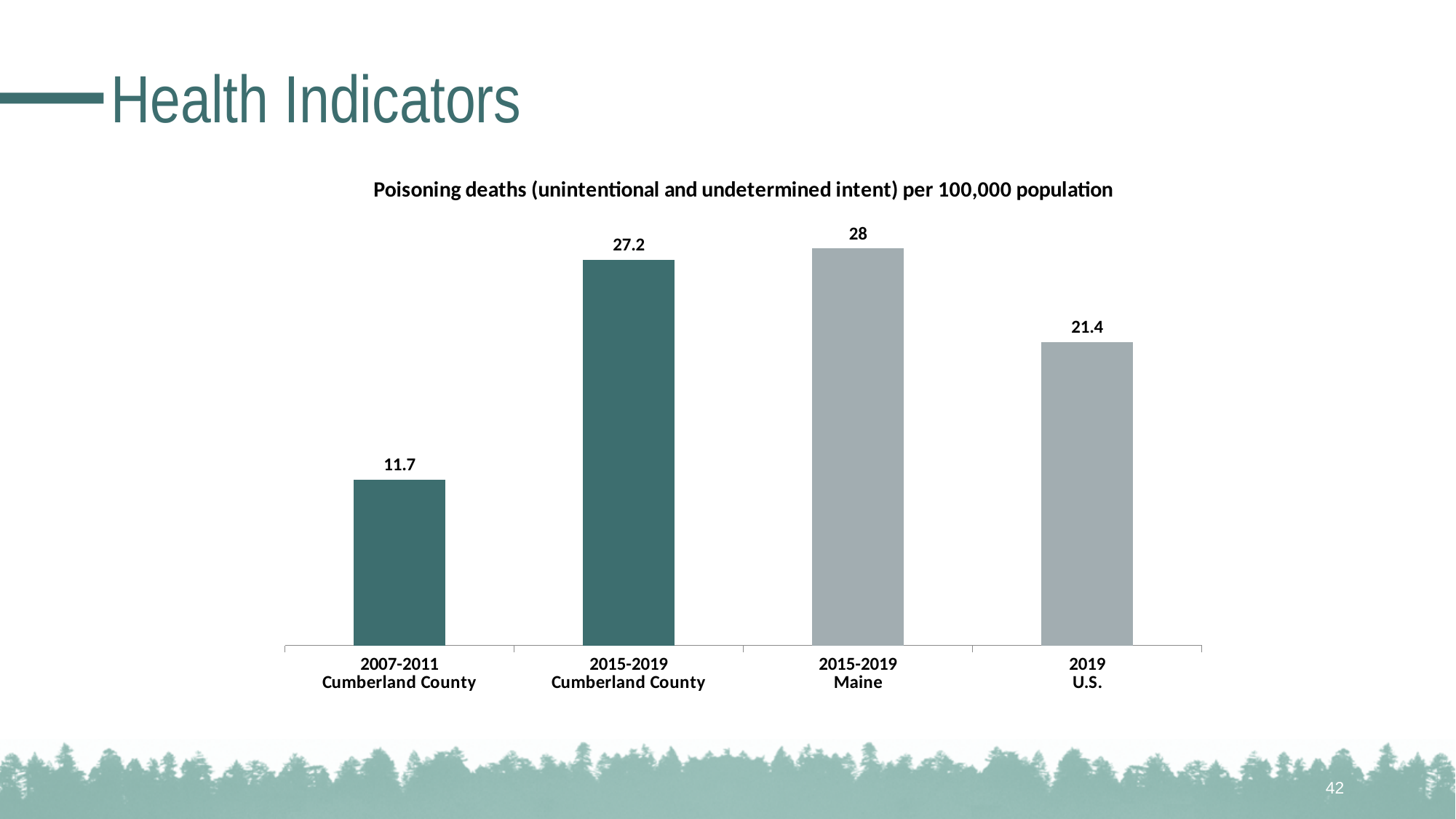
What kind of chart is shown on the slide? Bar chart What is the value for 2007-2011 Cumberland County? 11.7 What is the difference between the 2015-2019 Cumberland County value and the 2007-2011 Cumberland County value? 15.5 What is the difference between the 2015-2019 Maine value and the 2019 U.S. value? 6.6 What is the value for 2015-2019 Cumberland County? 27.2 What is the title of the chart? Poisoning deaths (unintentional and undetermined intent) per 100,000 population Which is larger, the value for 2015-2019 Cumberland County or the value for 2019 U.S.? 2015-2019 Cumberland County How many categories are shown in the chart? 4 Which category has the highest value? 2015-2019 Maine What is the value for 2019 U.S.? 21.4 What is the value for 2015-2019 Maine? 28 Which category has the lowest value? 2007-2011 Cumberland County